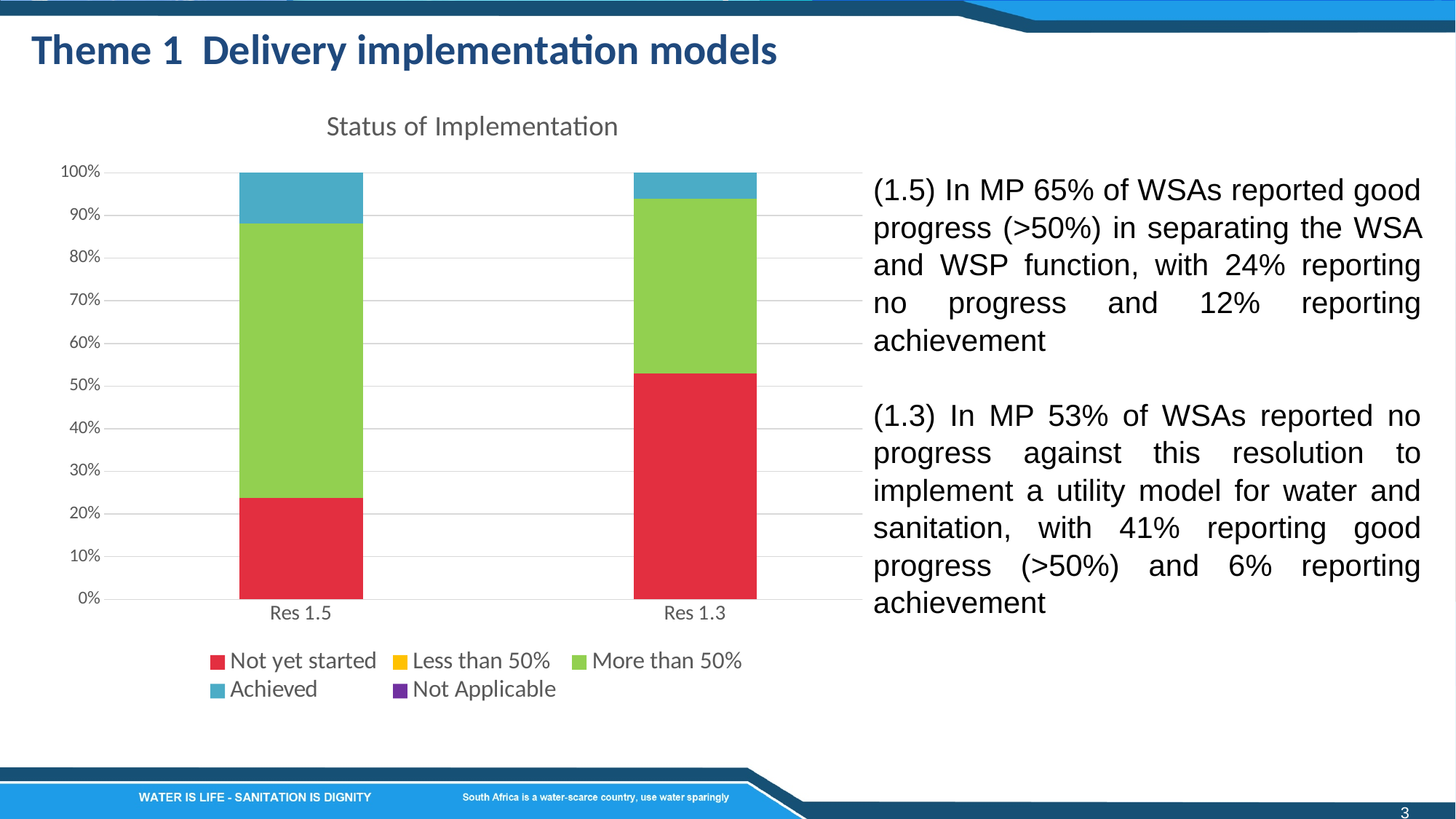
Is the 'Not yet started' value for Res 1.5 greater or less than 30%? less What is the title of the chart? Status of Implementation What type of chart is shown on the slide? Stacked bar chart What is the total height of the stacked bar for Res 1.5? 100% Is the 'Not yet started' value for Res 1.3 greater or less than 50%? greater How many series does the chart legend list? 5 Is the 'Achieved' value for Res 1.3 greater or less than 10%? less What colour represents the 'Not yet started' series in the chart? Red Which category has the larger 'More than 50%' share, Res 1.5 or Res 1.3? Res 1.5 Which category has the larger 'Achieved' share, Res 1.5 or Res 1.3? Res 1.5 Which category has the larger 'Not yet started' share, Res 1.5 or Res 1.3? Res 1.3 How many categories are shown on the x axis of the chart? 2